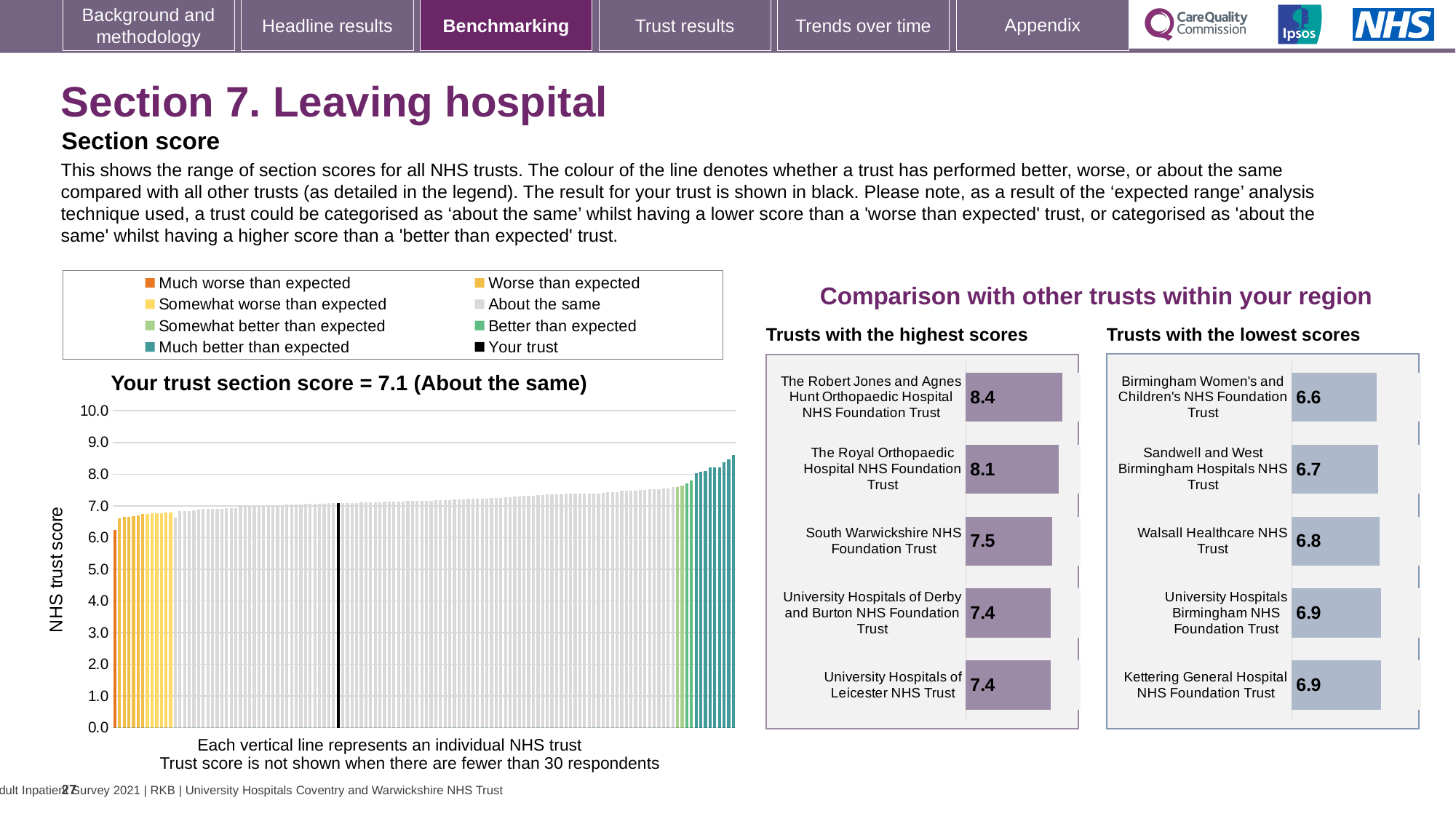
On the 'Your trust section score' chart, is the value of the leftmost (lowest) bar greater or less than 7.0? less What is the y-axis label of the 'Your trust section score' chart? NHS trust score What kind of chart is the 'Your trust section score' chart on the left of the slide? bar chart On the 'Your trust section score' chart, do the bars rise or fall from left to right? rise On the 'Trusts with the highest scores' chart, what is the difference between the scores of The Robert Jones and Agnes Hunt Orthopaedic Hospital NHS Foundation Trust and South Warwickshire NHS Foundation Trust? 0.9 On the 'Trusts with the highest scores' chart, what is the score for The Royal Orthopaedic Hospital NHS Foundation Trust? 8.1 On the 'Trusts with the highest scores' chart, which trust has the highest score? The Robert Jones and Agnes Hunt Orthopaedic Hospital NHS Foundation Trust On the 'Trusts with the lowest scores' chart, how many trusts are shown? 5 On the 'Your trust section score' chart, what is the section score for your trust? 7.1 How many entries does the legend above the 'Your trust section score' chart list? 8 On the 'Trusts with the lowest scores' chart, which trust has the lowest score? Birmingham Women's and Children's NHS Foundation Trust On the 'Your trust section score' chart, is the value of the rightmost (highest) bar greater or less than 8.0? greater